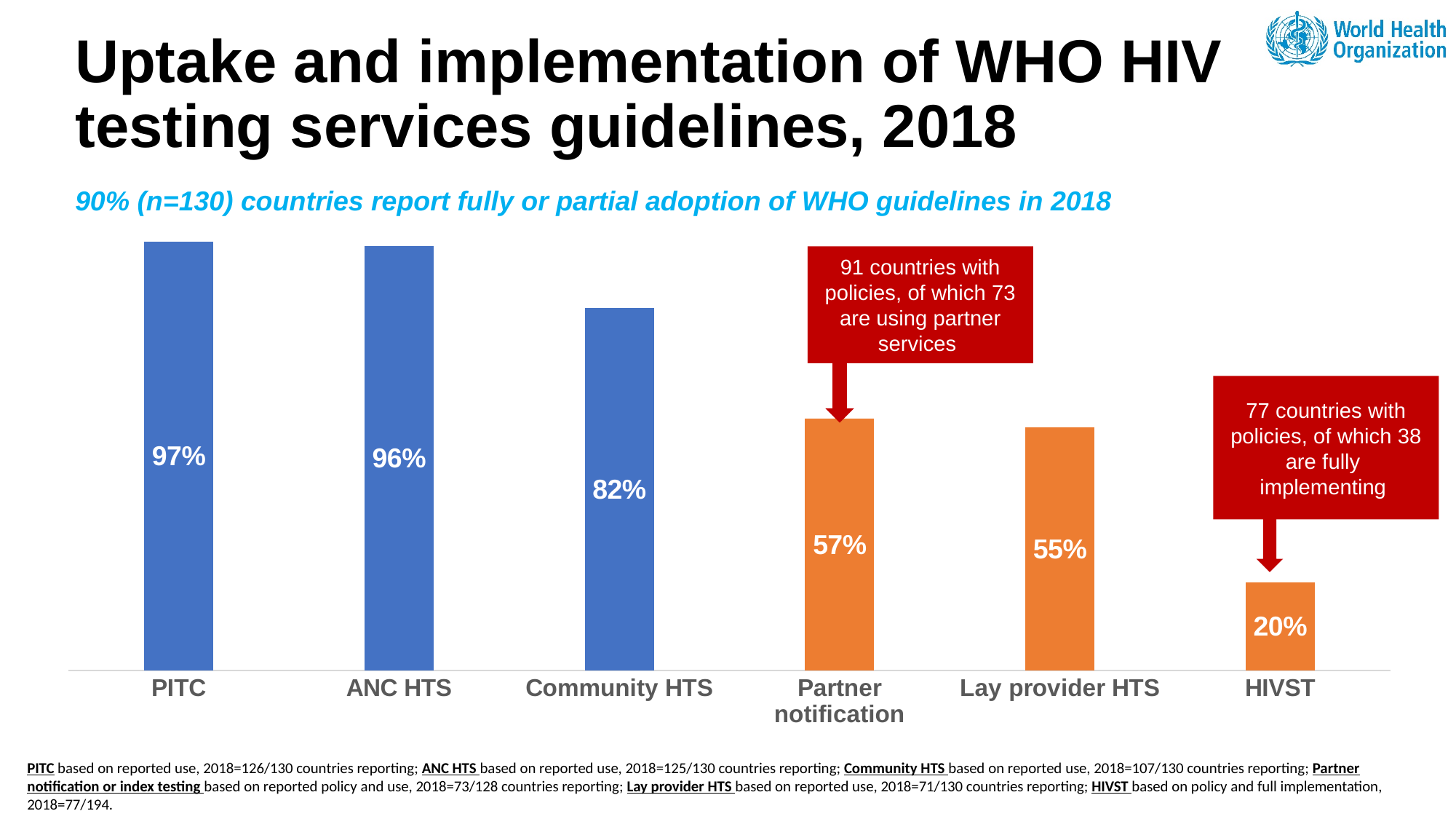
Which category has the highest value? PITC What is the difference between the values for ANC HTS and Partner notification? 39% What kind of chart is shown on the slide? Bar chart Which category has the lowest value? HIVST What colour are the bars for Partner notification, Lay provider HTS and HIVST? Orange What is the value for Lay provider HTS? 55% What is the value for HIVST? 20% Do the values rise or fall from left to right across the categories? Fall Which is larger, the value for Community HTS or the value for Lay provider HTS? Community HTS How many categories are shown in the chart? 6 What is the value for Community HTS? 82% What is the value for PITC? 97%